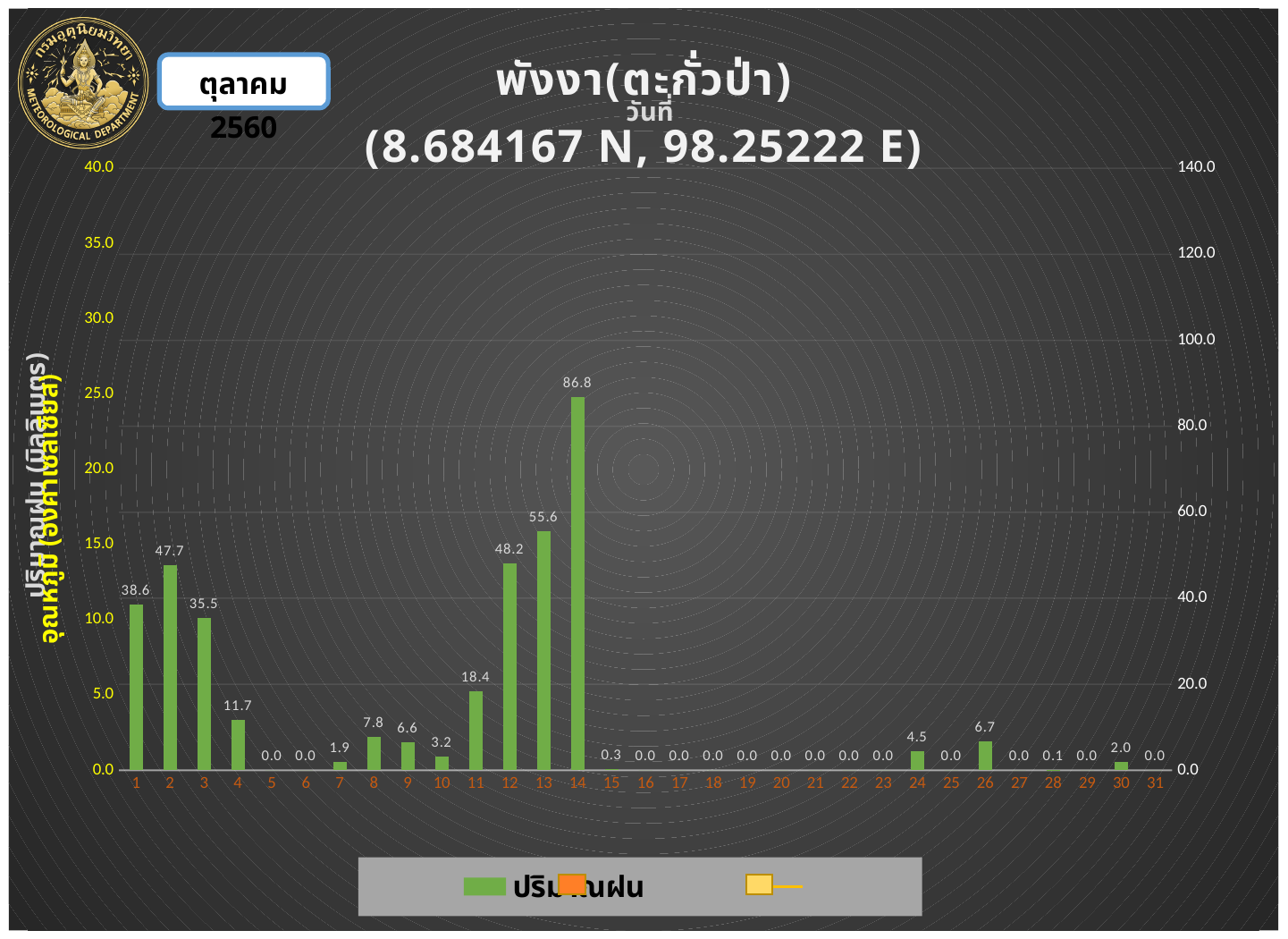
What is the rainfall value for day 28? 0.1 What is the rainfall value for day 24? 4.5 Which day has the larger rainfall value, day 2 or day 12? 12 What is the rainfall value for day 13? 55.6 What is the difference between the rainfall values for day 1 and day 3? 3.1 How many days are shown on the x axis? 31 What is the difference between the rainfall values for day 14 and day 13? 31.2 What month and year are shown in the box at the top left of the slide? ตุลาคม 2560 What is the rainfall value for day 11? 18.4 What is the rainfall value for day 14? 86.8 What kind of chart is shown on the slide? bar chart Which day has the highest rainfall value? 14